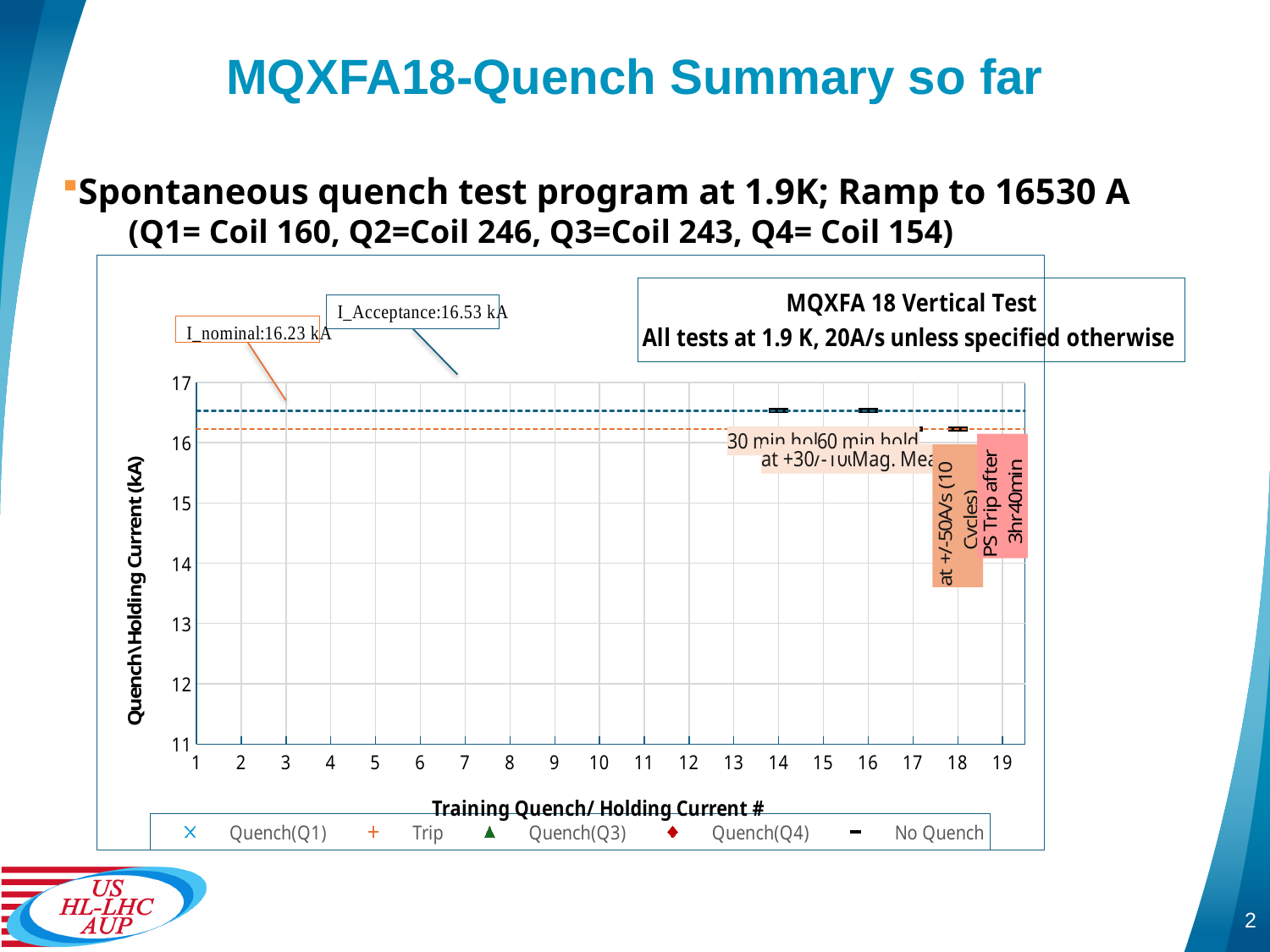
Which plotted point is higher: the one at # 14 or the one at # 18? # 14 Is the value plotted at Training Quench/ Holding Current # 16 greater or less than 17? less How many series does the chart legend list? 5 What kind of chart is shown on the slide? scatter chart What is the I_Acceptance value annotated on the chart? 16.53 kA What is the highest value shown on the x axis? 19 Which legend entry is represented by a black dash marker? No Quench Is the value plotted at Training Quench/ Holding Current # 14 greater or less than 16? greater What is the title of the chart's y axis? Quench\Holding Current (kA) What is the I_nominal value annotated on the chart? 16.23 kA